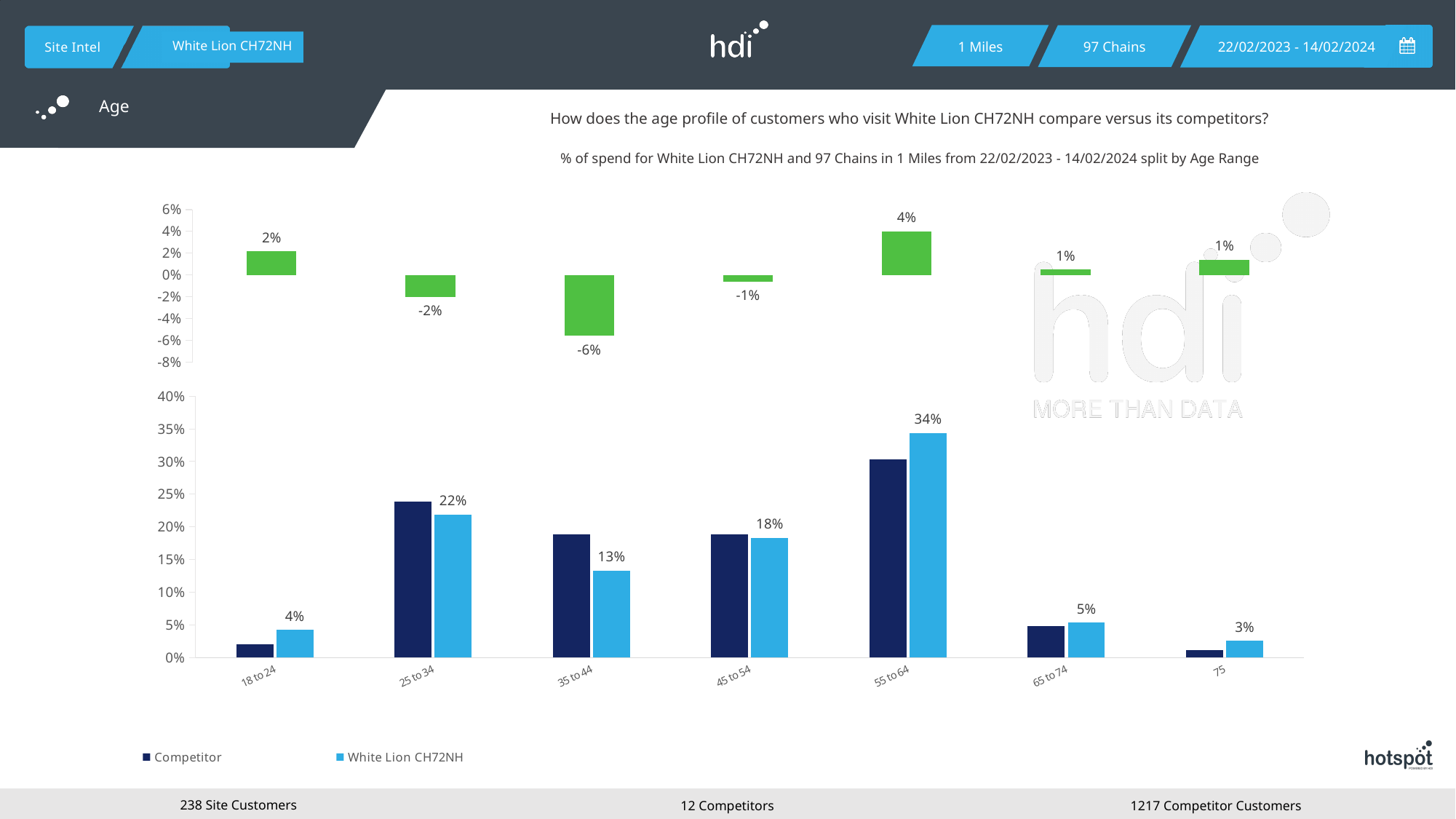
How many age range categories are shown in the bottom bar chart? 7 In the top chart, which age range has the highest value? 55 to 64 In the bottom bar chart, what is the value for White Lion CH72NH in the 55 to 64 age range? 34% In the bottom bar chart, is the Competitor value for 18 to 24 greater or less than 5%? less In the bottom bar chart, which age range has the lowest White Lion CH72NH value? 75 In the bottom bar chart, which age range has the highest White Lion CH72NH value? 55 to 64 In the bottom bar chart, what is the difference between the White Lion CH72NH values for 25 to 34 and 18 to 24? 18% How many series does the legend of the bottom bar chart list? 2 In the top chart, what is the value shown for the 35 to 44 age range? -6% In the bottom bar chart, is the Competitor value for 55 to 64 greater or less than 25%? greater In the bottom bar chart, which is larger for the 35 to 44 age range, the Competitor bar or the White Lion CH72NH bar? Competitor In the bottom bar chart, what is the value for White Lion CH72NH in the 35 to 44 age range? 13%